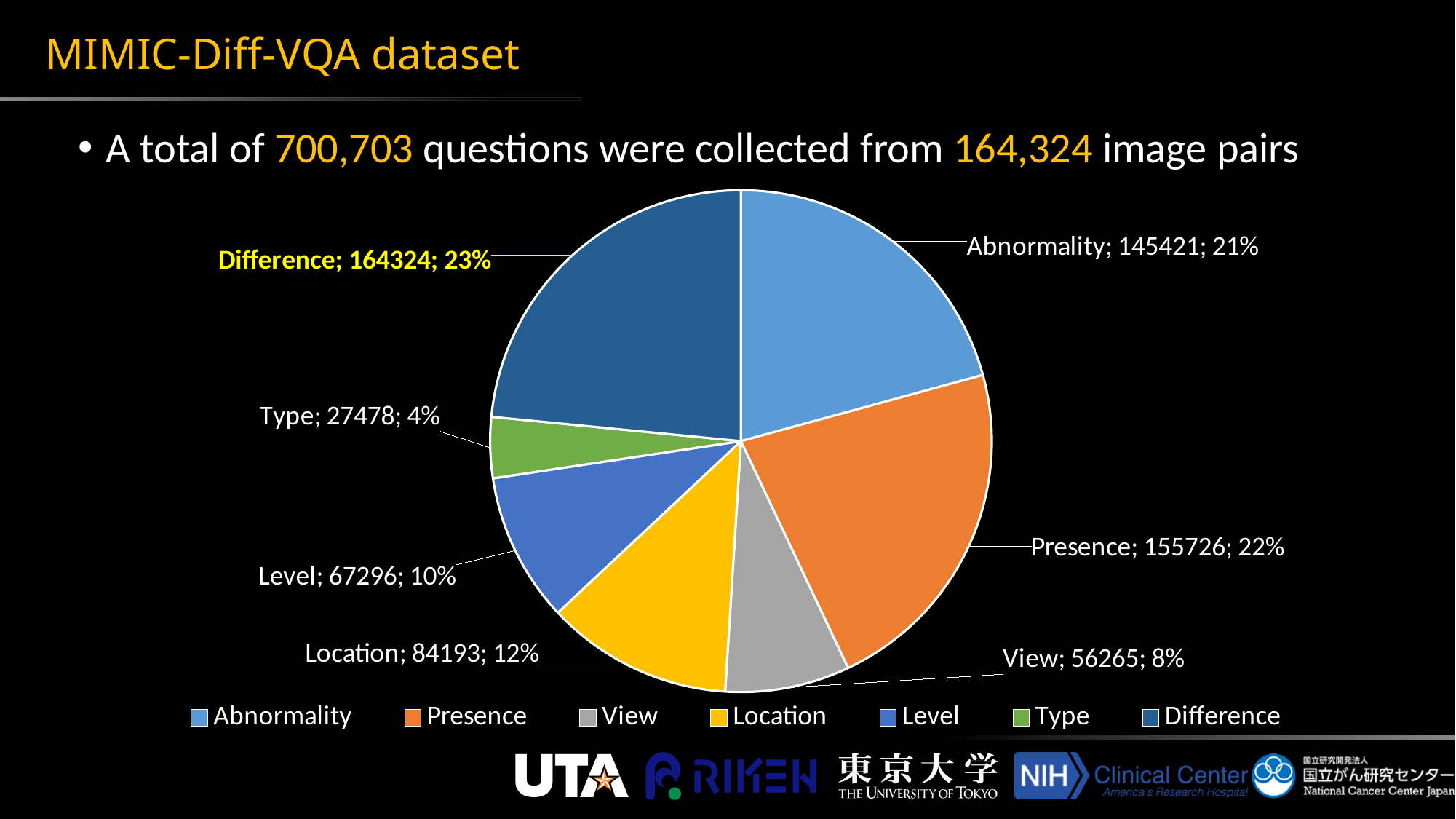
What percentage share does the View slice have? 8% What is the value for Level? 67296 Which is larger, the value for Abnormality or the value for Level? Abnormality What is the value for Presence? 155726 What is the difference between the values for Location and View? 27928 What kind of chart is shown on the slide? pie chart Which category has the smallest slice? Type Which slice's label is highlighted in yellow? Difference How many entries does the legend list? 7 Which category has the largest slice? Difference What percentage share does the Difference slice have? 23% How many slices does the pie chart have? 7